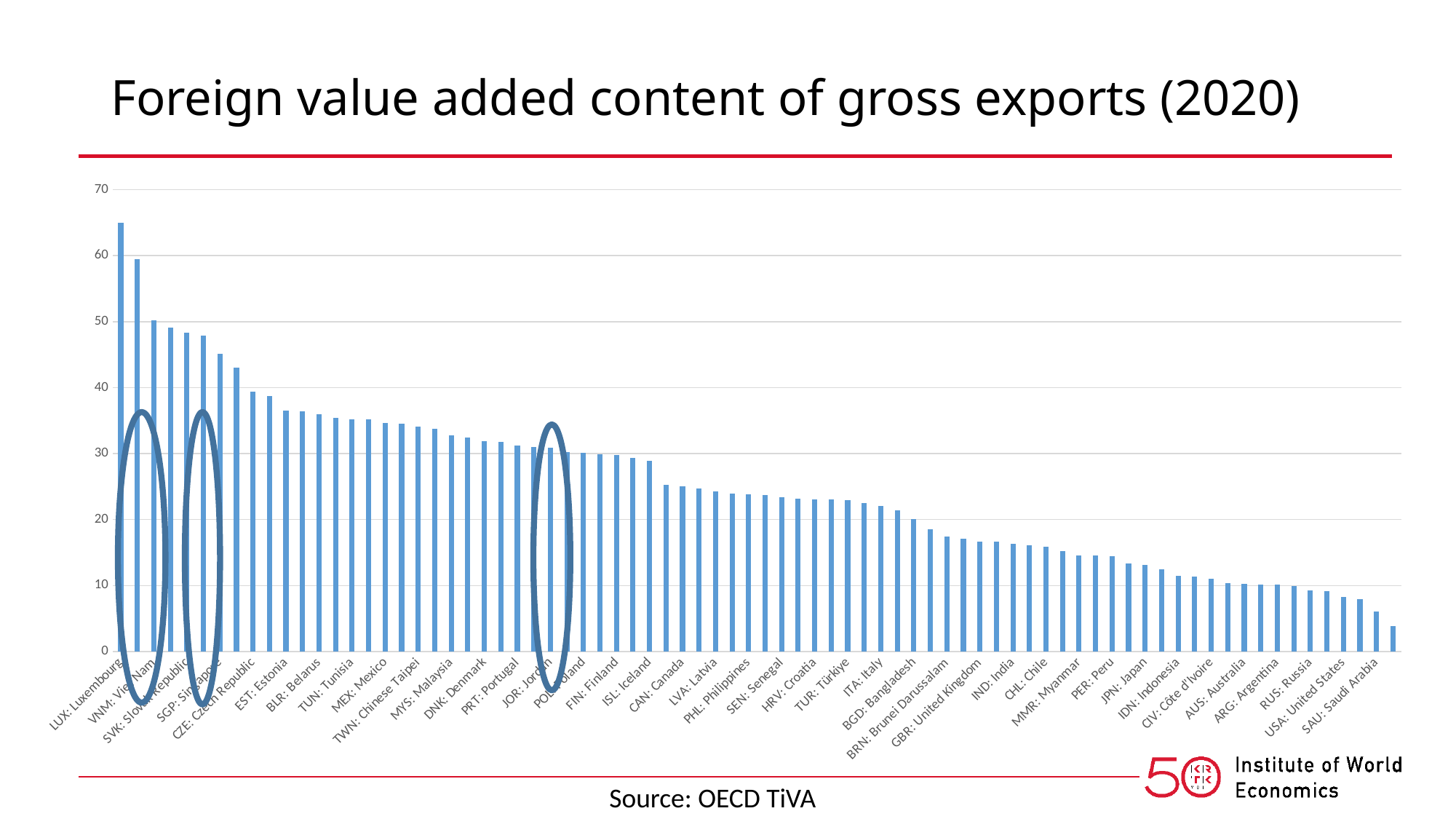
Is the value for LUX: Luxembourg greater or less than 60? greater Is the value for GBR: United Kingdom greater or less than 20? less Do the values rise or fall moving from left to right along the x axis? fall Which country has the highest foreign value added content of gross exports? LUX: Luxembourg What kind of chart is shown on the slide? bar chart What is the title of the chart? Foreign value added content of gross exports (2020) Is the value for USA: United States greater or less than 10? less Which has a higher value, LUX: Luxembourg or VNM: Viet Nam? LUX: Luxembourg Which has a higher value, MEX: Mexico or CAN: Canada? MEX: Mexico